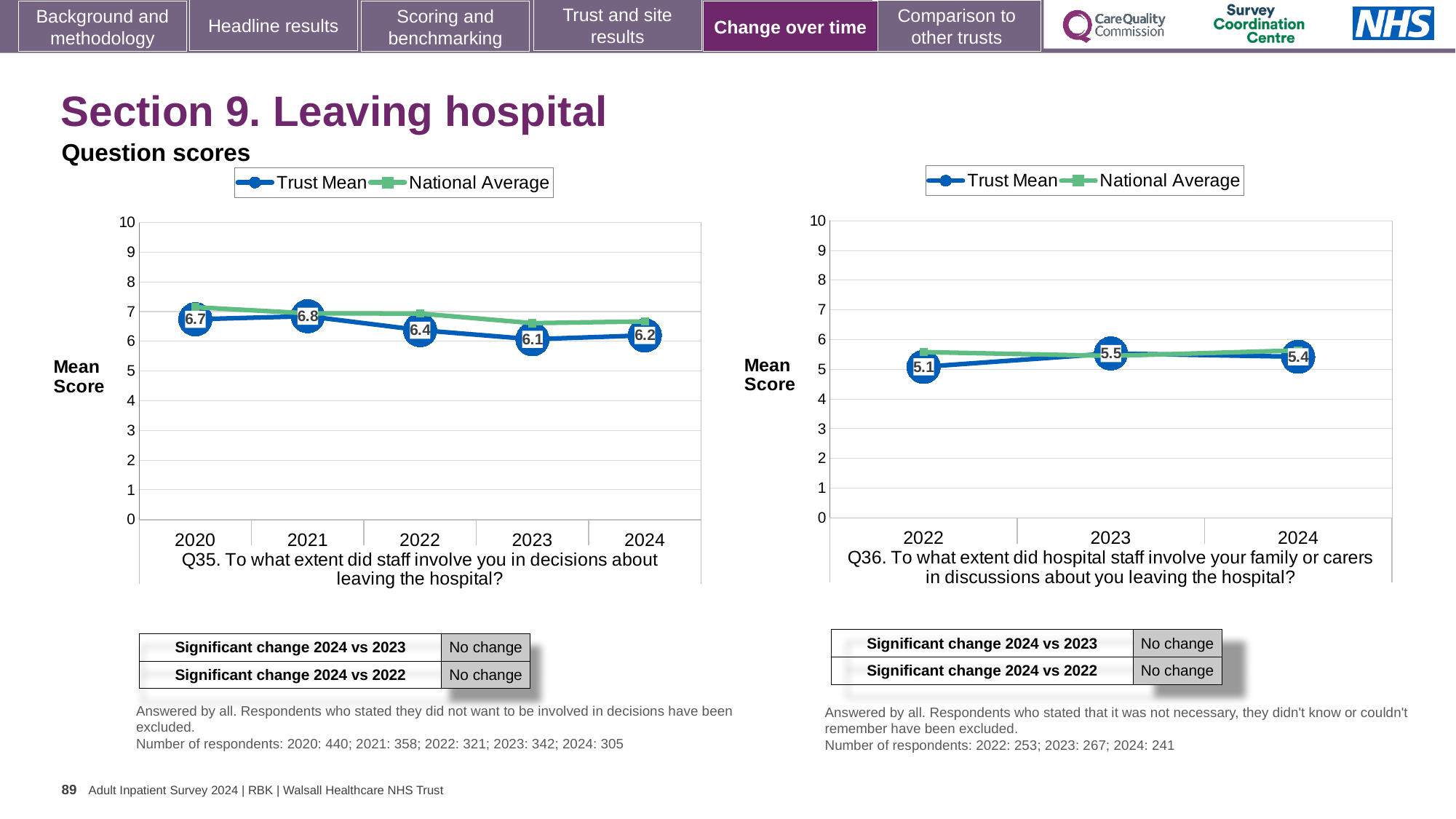
In the Q35 chart (left), what is the Trust Mean for 2021? 6.8 In the Q35 chart (left), which year has the highest Trust Mean? 2021 How many series does the legend of the Q35 chart (left) list? 2 In the Q36 chart (right), what is the Trust Mean for 2022? 5.1 In the Q36 chart (right), which year has the lowest Trust Mean? 2022 In the Q35 chart (left), what is the Trust Mean for 2024? 6.2 How many years are plotted on the x axis of the Q36 chart (right)? 3 In the Q36 chart (right), is the National Average for 2022 greater or less than 5? greater In the Q35 chart (left), is the Trust Mean higher in 2020 or in 2022? 2020 In the Q35 chart (left), which year has the lowest Trust Mean? 2023 In the Q35 chart (left), what is the difference between the Trust Mean in 2021 and in 2023? 0.7 In the Q36 chart (right), what is the difference between the Trust Mean in 2023 and in 2022? 0.4